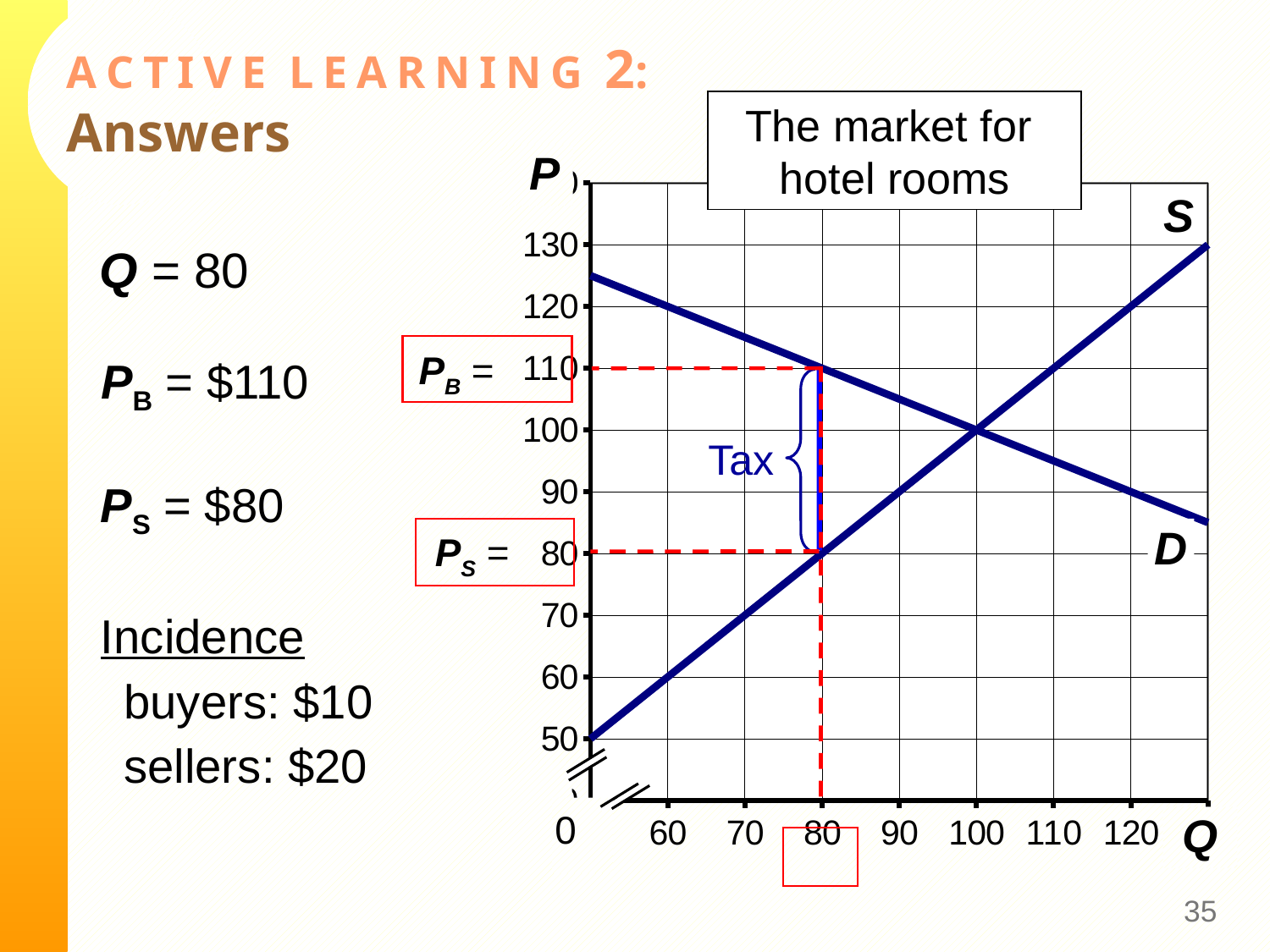
What is the title of the chart? The market for hotel rooms How many curves are plotted on the chart? 2 Does the S curve rise or fall as Q increases? rises What is the difference between PB and PS at Q = 80 (the size of the tax)? 30 What is the price on the D curve at Q = 80 (the buyers' price PB)? 110 What kind of chart is shown on the slide? line chart Does the D curve rise or fall as Q increases? falls What are the labels of the two curves on the chart? S and D At Q = 80, which curve has the higher price, S or D? D What is the price on the S curve at Q = 80 (the sellers' price PS)? 80 At what quantity do the S and D curves intersect? 100 At what price do the S and D curves intersect? 100